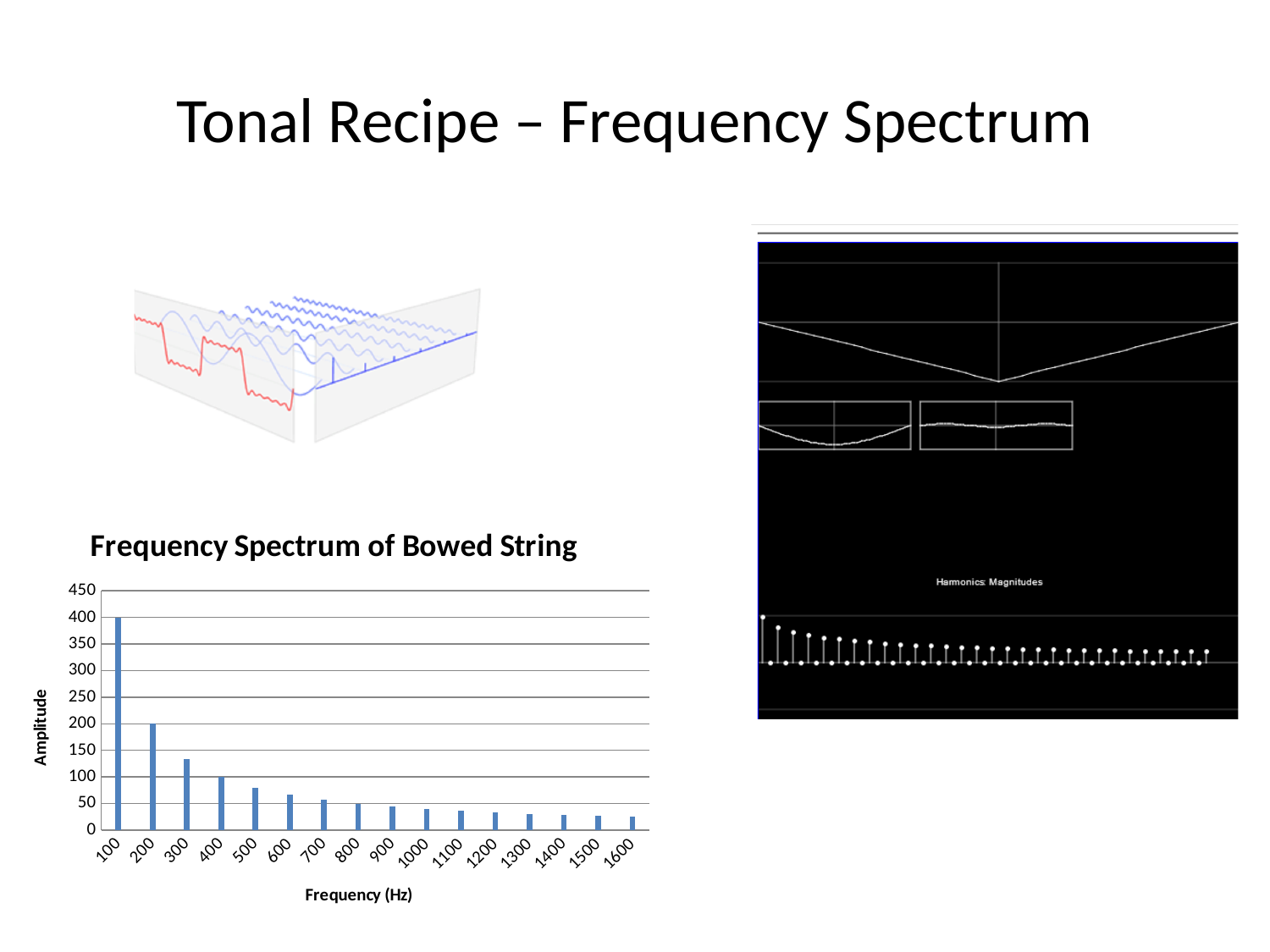
What is the amplitude at 400 Hz in the Frequency Spectrum of Bowed String chart? 100 How many frequency categories are shown on the x axis of the Frequency Spectrum of Bowed String chart? 16 Is the amplitude at 300 Hz in the Frequency Spectrum of Bowed String chart greater or less than 100? greater What is the amplitude at 800 Hz in the Frequency Spectrum of Bowed String chart? 50 What is the difference in amplitude between 100 Hz and 200 Hz in the Frequency Spectrum of Bowed String chart? 200 Is the amplitude at 500 Hz in the Frequency Spectrum of Bowed String chart greater or less than 100? less Do the amplitudes rise or fall as frequency increases along the x axis of the Frequency Spectrum of Bowed String chart? fall Which frequency has the highest amplitude in the Frequency Spectrum of Bowed String chart? 100 Which has the larger amplitude in the Frequency Spectrum of Bowed String chart, 300 Hz or 500 Hz? 300 What is the amplitude at 200 Hz in the Frequency Spectrum of Bowed String chart? 200 What is the amplitude at 100 Hz in the Frequency Spectrum of Bowed String chart? 400 What type of chart is "Frequency Spectrum of Bowed String"? bar chart